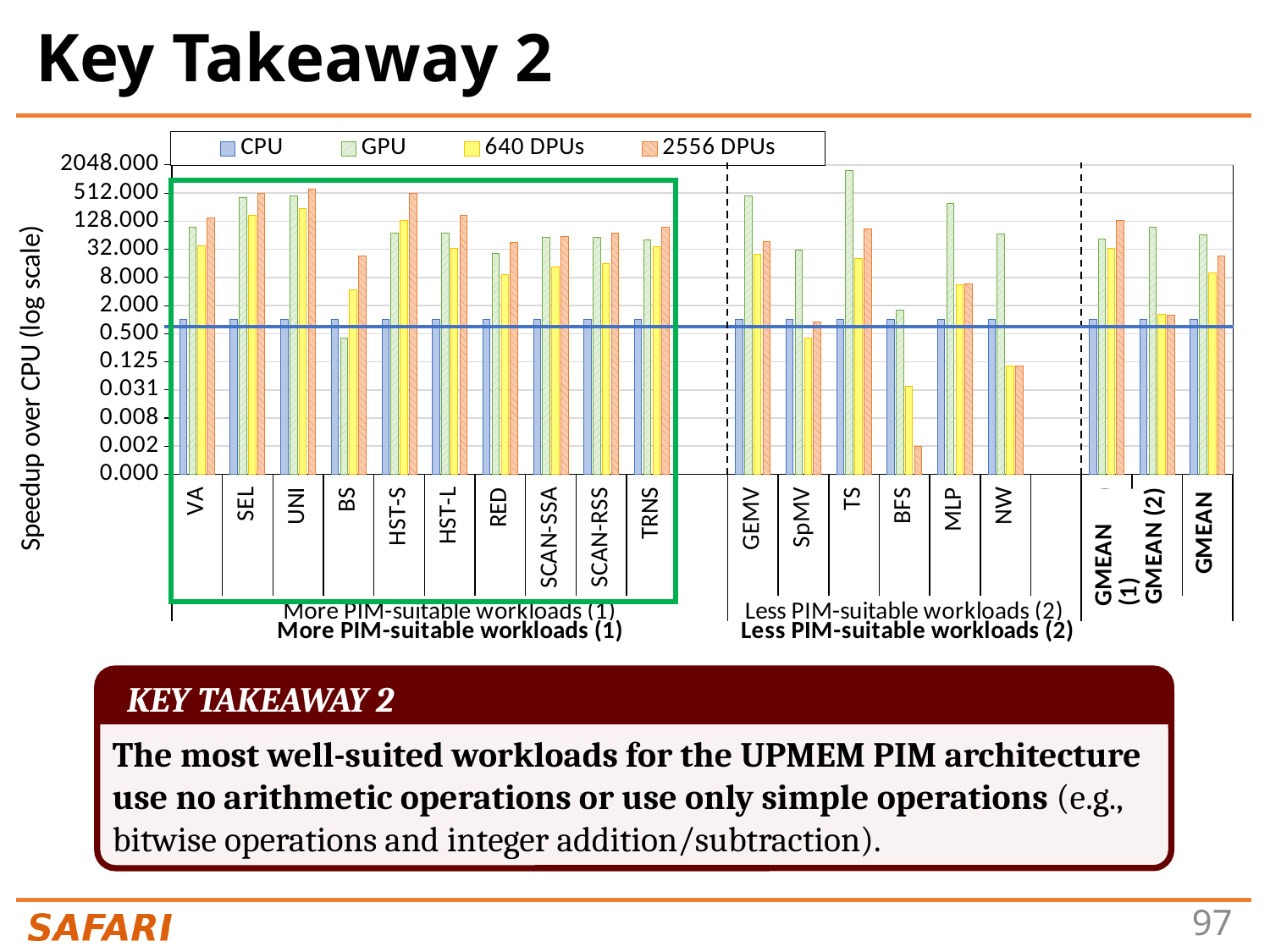
Is the 2556 DPUs value for BFS greater or less than 0.031? less For BS, which is larger: the GPU bar or the 2556 DPUs bar? 2556 DPUs What kind of chart is shown on the slide? bar chart Which workload has the lowest 2556 DPUs bar? BFS How many workloads are grouped under "Less PIM-suitable workloads (2)"? 6 How many workloads are grouped under "More PIM-suitable workloads (1)"? 10 Is the GPU value for GEMV greater or less than 128.000? greater What is the label of the y axis? Speedup over CPU (log scale) Is the 640 DPUs value for NW greater or less than 0.500? less Which workload has the highest GPU bar? TS How many series does the legend list? 4